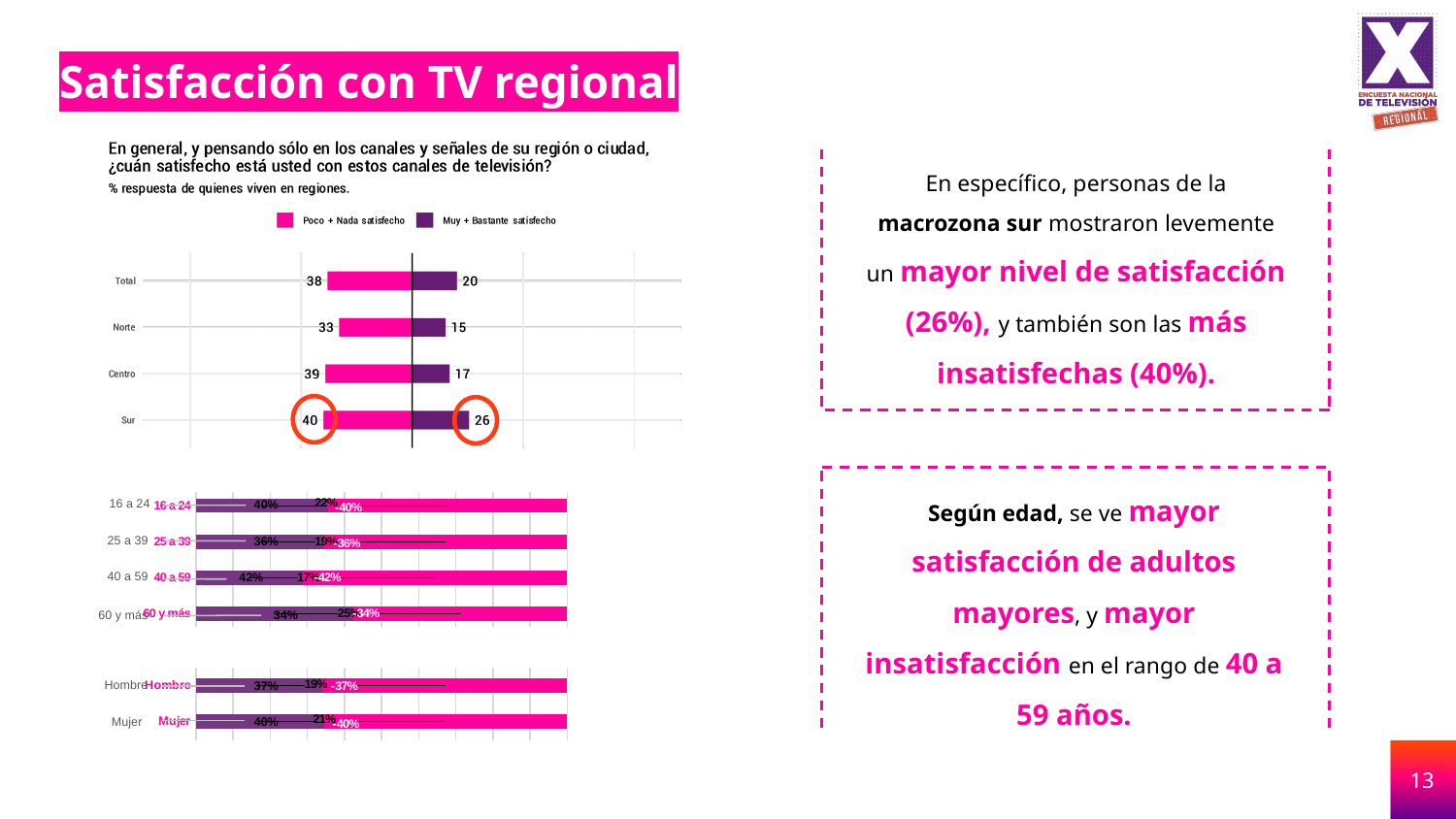
In the top chart by region, how many series does the legend list? 2 In the bottom chart by age, what is the Poco + Nada satisfecho value for the 40 a 59 group? 42% What type of chart is the top chart by region? Bar chart In the top chart by region, what is the value for Muy + Bastante satisfecho for Total? 20 In the top chart by region, what is the value for Poco + Nada satisfecho for Sur? 40 In the top chart by region, which colour represents Poco + Nada satisfecho? Pink In the top chart by region, which region has the lowest Poco + Nada satisfecho value? Norte In the top chart by region, which region has the highest Muy + Bastante satisfecho value? Sur In the top chart by region, is the Muy + Bastante satisfecho value larger for Sur or for Centro? Sur In the top chart by region, what is the value for Muy + Bastante satisfecho for Norte? 15 In the top chart by region, how many regions (categories) are shown? 4 In the top chart by region, what is the difference between the Poco + Nada satisfecho and Muy + Bastante satisfecho values for Centro? 22